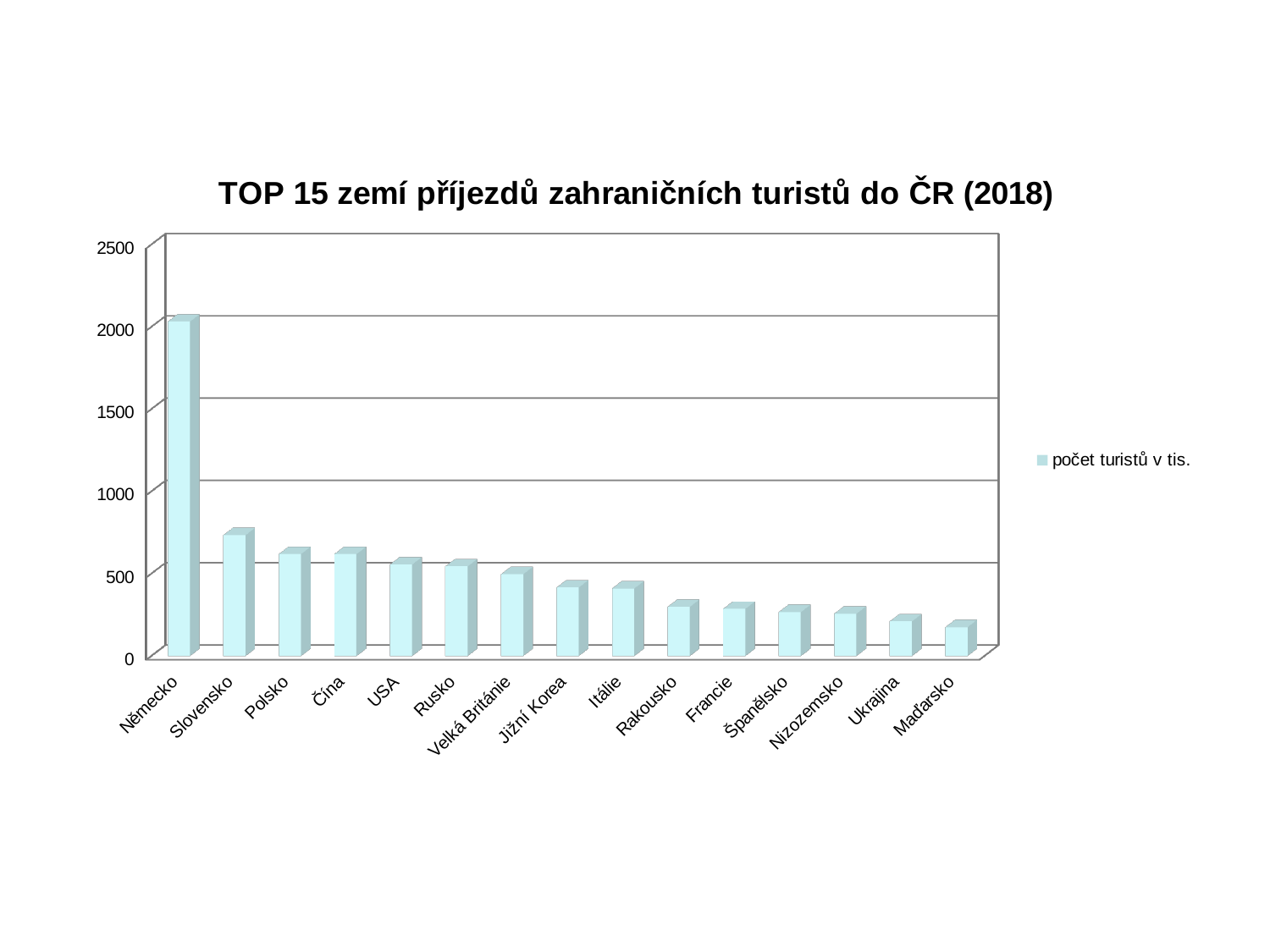
How many series does the legend list? 1 What is the legend entry for the series in the chart? počet turistů v tis. Is the value for Německo greater or less than 1500? greater Which country has the highest number of tourists in the chart? Německo How many countries are shown on the x axis of the chart? 15 What kind of chart is shown on the slide? bar chart Is the value for Rakousko greater or less than 500? less Which has a larger value, Slovensko or Polsko? Slovensko Do the values rise or fall moving from left to right along the x axis? fall Is the value for Slovensko greater or less than 500? greater Which country has the lowest number of tourists in the chart? Maďarsko What is the title of the chart? TOP 15 zemí příjezdů zahraničních turistů do ČR (2018)